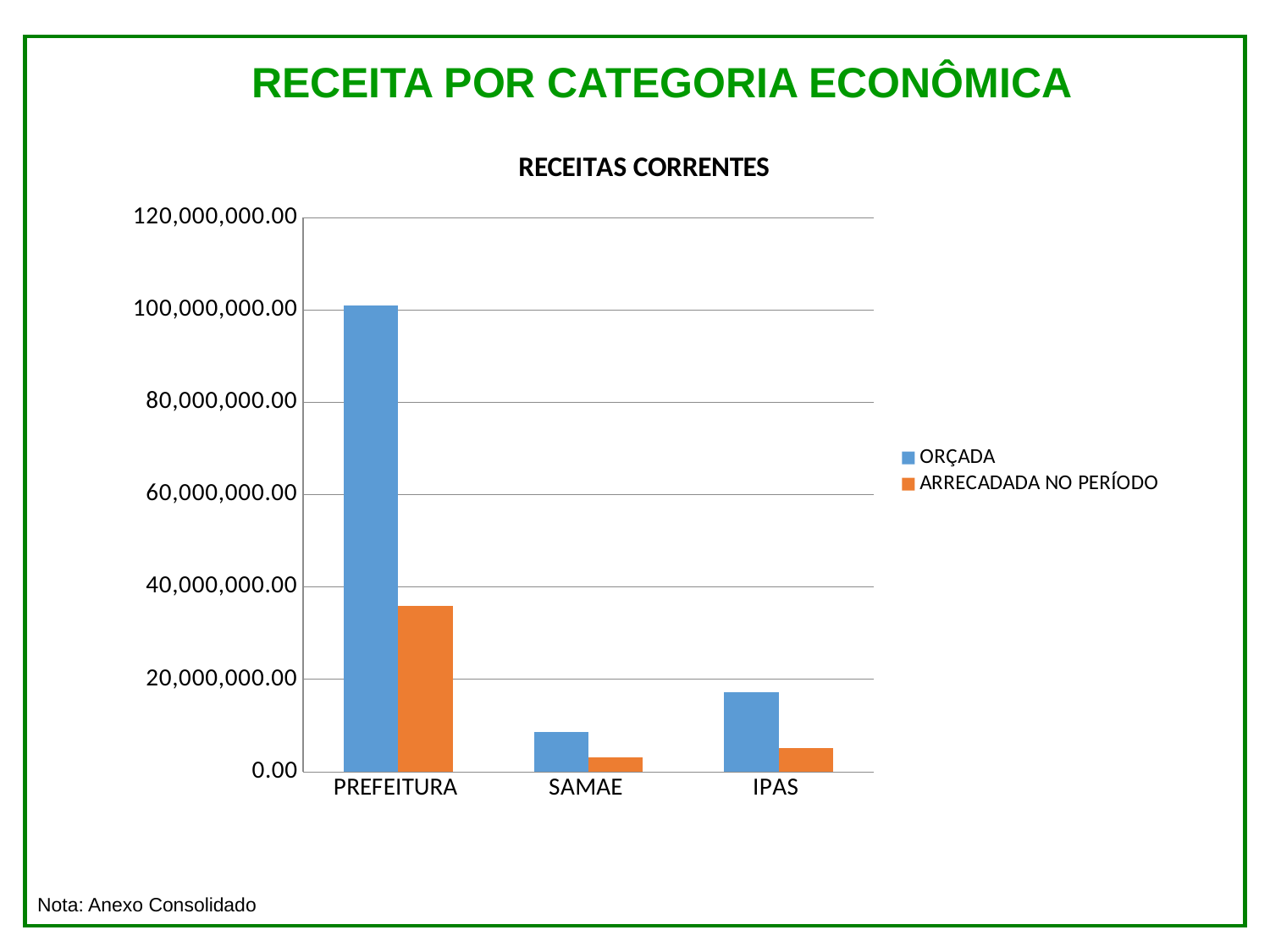
How many series does the legend list? 2 Which category has the lowest ARRECADADA NO PERÍODO value? SAMAE Which has a larger ORÇADA value, IPAS or SAMAE? IPAS Is the ORÇADA value for IPAS greater or less than 20,000,000.00? less Is the ORÇADA value for PREFEITURA greater or less than 80,000,000.00? greater What is the title of the chart? RECEITAS CORRENTES How many categories are shown on the x axis? 3 Which category has the lowest ORÇADA value? SAMAE Which colour represents the ARRECADADA NO PERÍODO series? Orange Is the ARRECADADA NO PERÍODO value for PREFEITURA greater or less than 40,000,000.00? less Which category has the highest ORÇADA value? PREFEITURA What type of chart is shown on the slide? Bar chart